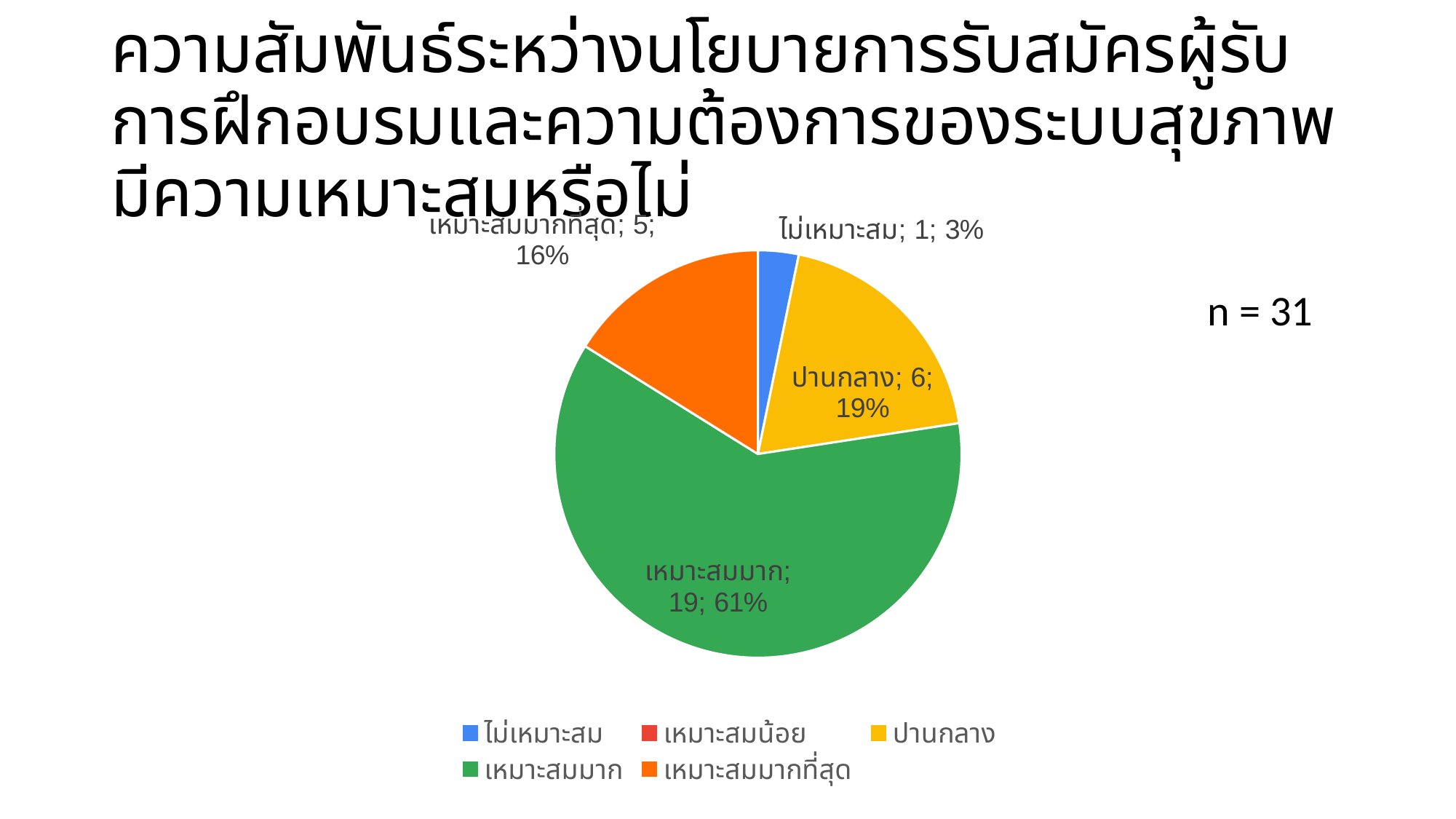
What kind of chart is shown on the slide? Pie chart Which has more respondents, ปานกลาง or เหมาะสมมากที่สุด? ปานกลาง How many respondents answered เหมาะสมมาก? 19 What share of the pie is เหมาะสมมากที่สุด? 16% How many respondents answered ไม่เหมาะสม? 1 Which category with a visible slice has the smallest share of the pie? ไม่เหมาะสม How many entries does the legend list? 5 What is the total number of respondents (n) shown on the slide? 31 What colour is the slice for เหมาะสมมาก? Green What is the difference in count between เหมาะสมมาก and ปานกลาง? 13 What percentage of the pie does ปานกลาง represent? 19% Which category has the largest slice of the pie? เหมาะสมมาก